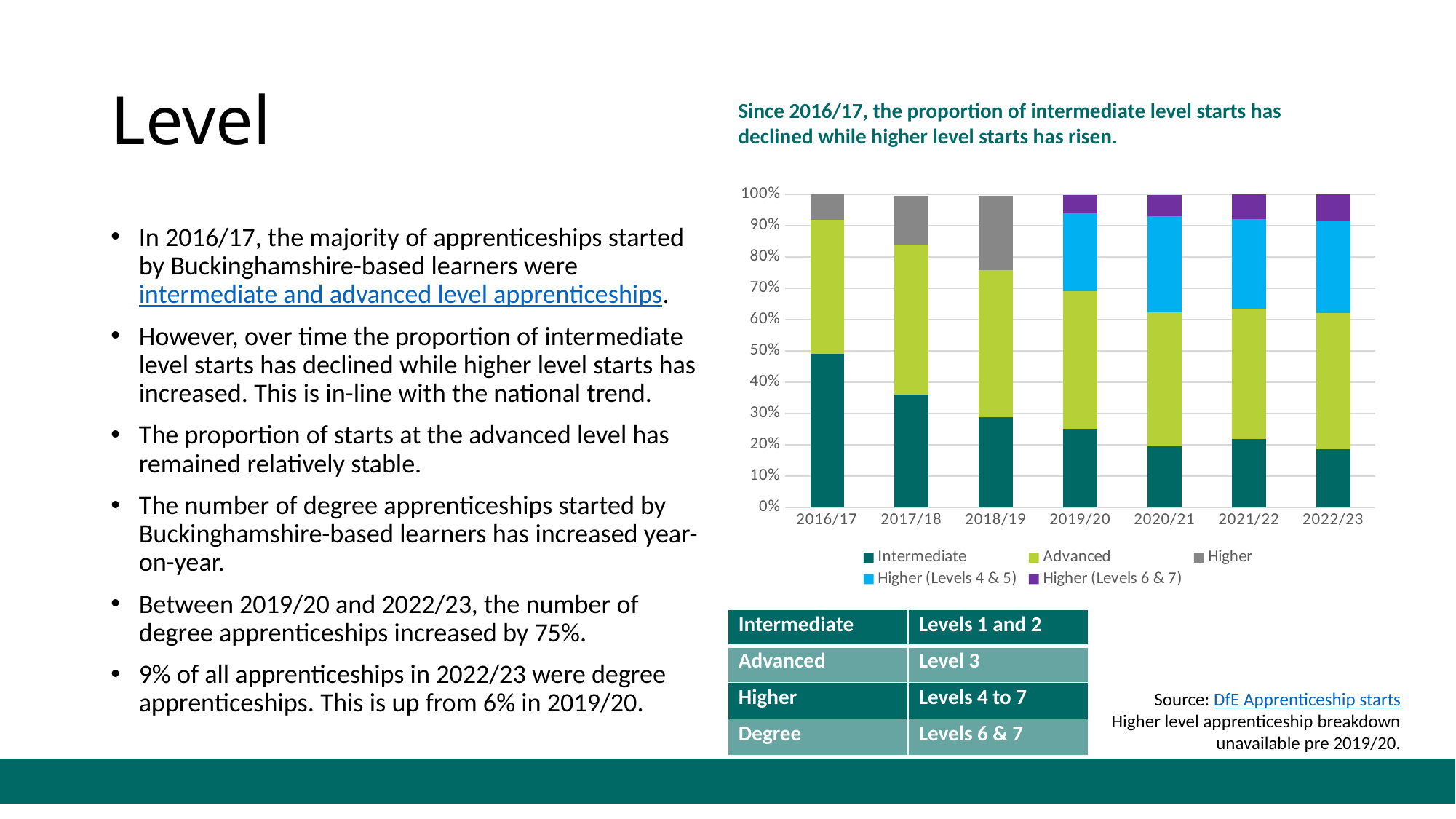
Which year has a larger Intermediate share, 2016/17 or 2017/18? 2016/17 Is the Intermediate share in 2017/18 greater or less than 30%? greater In which year is the Higher (grey) share of starts largest? 2018/19 Does the Intermediate share of starts rise or fall overall from 2016/17 to 2022/23? Fall In which year is the Intermediate share of starts highest? 2016/17 Is the Intermediate share in 2022/23 greater or less than 20%? less Is the Intermediate share in 2019/20 greater or less than 20%? greater What kind of chart is shown on the slide? Stacked bar chart How many series does the chart legend list? 5 Which series in the legend is shown in light blue? Higher (Levels 4 & 5) How many academic years are shown on the x axis of the chart? 7 From which year onwards does the chart split Higher starts into Levels 4 & 5 and Levels 6 & 7? 2019/20